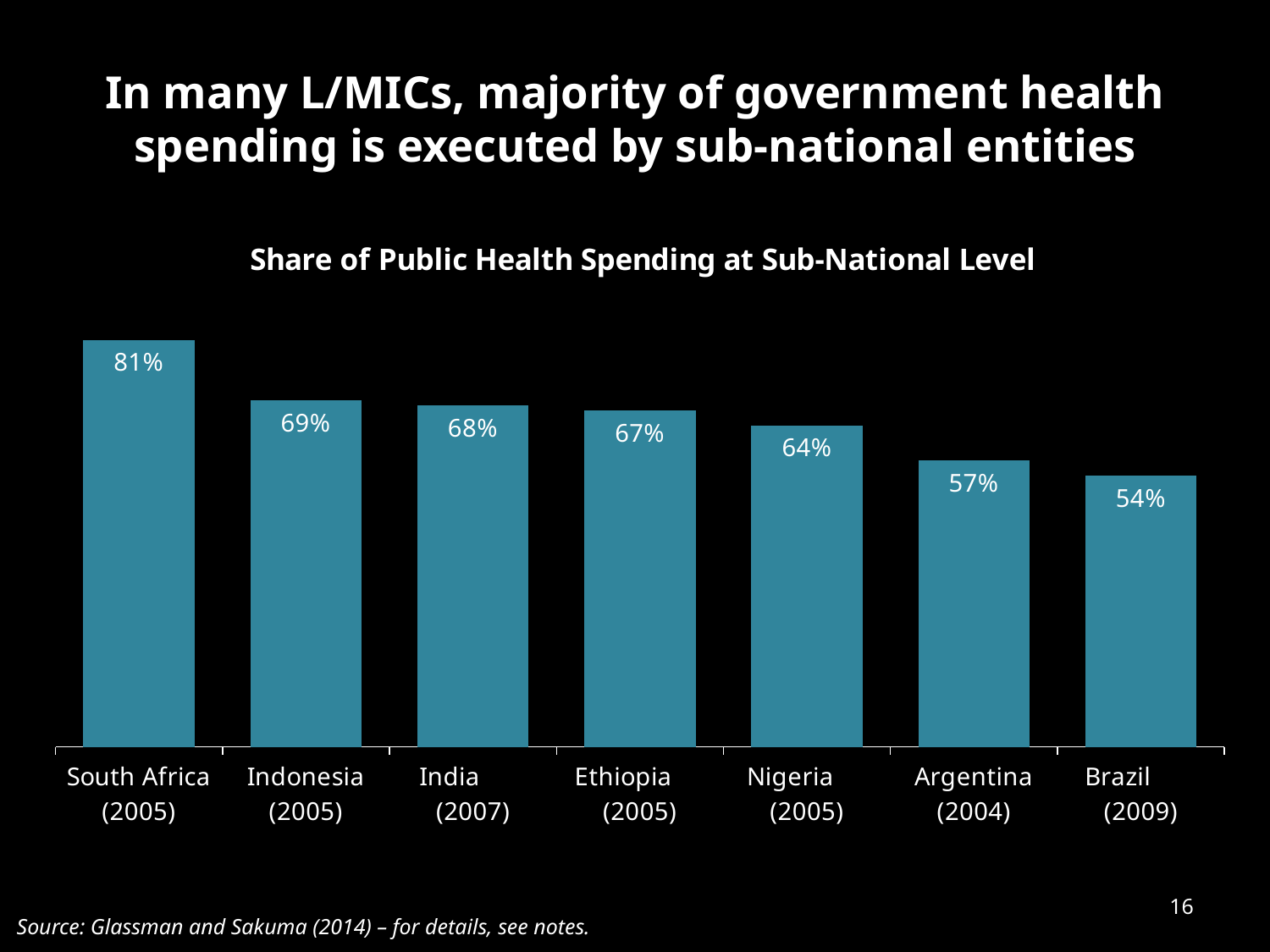
How many countries are shown in the chart? 7 Which country has the lowest share of public health spending at sub-national level? Brazil (2009) Which country has the highest share of public health spending at sub-national level? South Africa (2005) What is the value shown for Brazil (2009)? 54% What kind of chart is shown on the slide? Bar chart What is the difference between the values for Indonesia (2005) and Argentina (2004)? 12% Do the values rise or fall from left to right across the chart? Fall What is the title of the chart? Share of Public Health Spending at Sub-National Level What is the difference between the values for South Africa (2005) and Brazil (2009)? 27% Which has a larger value, Ethiopia (2005) or Argentina (2004)? Ethiopia (2005) What is the share of public health spending at sub-national level for South Africa (2005)? 81% What is the value shown for Nigeria (2005)? 64%